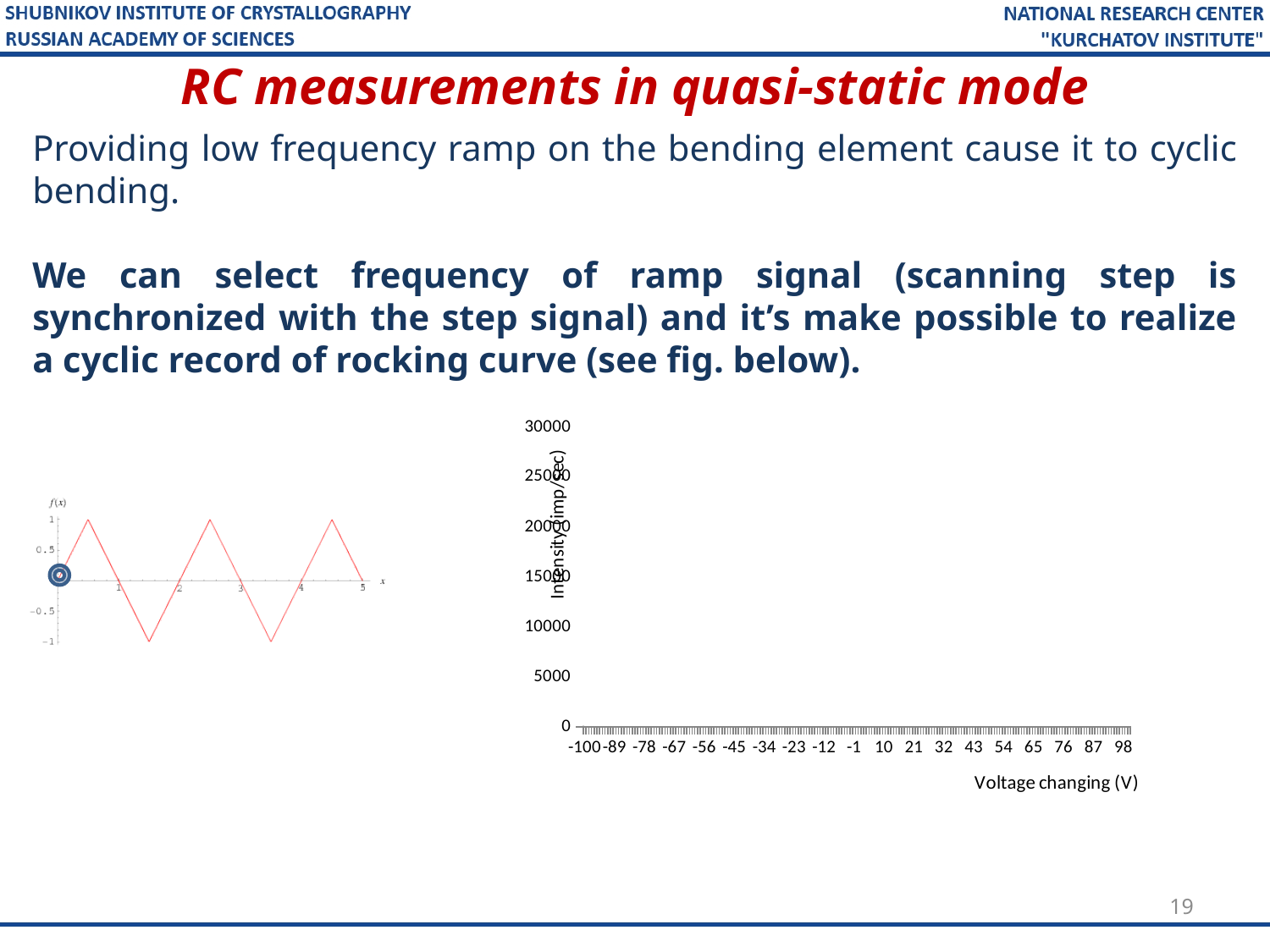
In the left chart, what is the maximum value reached by f(x)? 1 In the left chart, how many peaks does the f(x) curve have? 3 What is the y-axis label of the chart on the right of the slide? Intensity (imp/sec) In the left chart, does f(x) rise or fall between x = 0.5 and x = 1.5? fall What is the x-axis label of the chart on the right of the slide? Voltage changing (V) What kind of chart is the plot on the left of the slide? line chart In the left chart, what is the difference between the maximum and minimum values of f(x)? 2 In the left chart, what is the minimum value reached by f(x)? -1 In the left chart, does f(x) rise or fall between x = 1.5 and x = 2.5? rise